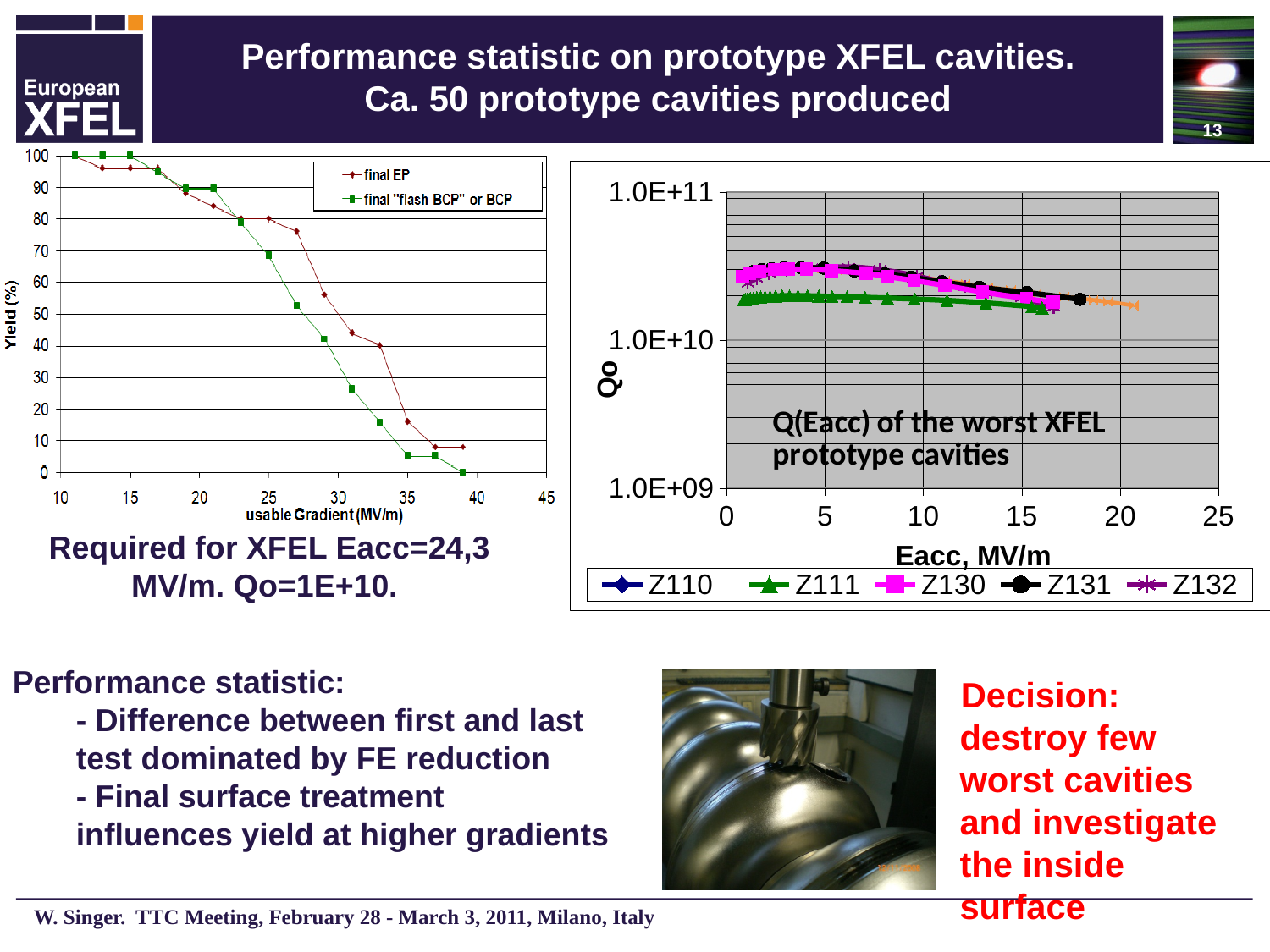
In the right chart (Qo versus Eacc), is the Qo value for Z111 at Eacc = 5 MV/m greater or less than 1.0E+10? greater In the left chart (Yield vs usable Gradient), does the yield rise or fall as the usable gradient increases? fall In the right chart (Qo versus Eacc), which series has the lower Qo at Eacc = 5 MV/m, Z111 or Z130? Z111 How many series does the legend of the left chart (Yield vs usable Gradient) list? 2 In the left chart (Yield vs usable Gradient), is the yield for 'final EP' at 35 MV/m greater or less than 20? less In the left chart (Yield vs usable Gradient), what are the two legend entries? final EP; final "flash BCP" or BCP What kind of chart is the left chart showing Yield (%) versus usable Gradient? line chart In the left chart (Yield vs usable Gradient), is the yield for 'final EP' at 25 MV/m greater or less than 70? greater How many series does the legend of the right chart (Qo versus Eacc) list? 5 What is the title printed inside the right chart (Qo versus Eacc)? Q(Eacc) of the worst XFEL prototype cavities In the left chart (Yield vs usable Gradient), which series has the higher yield at a usable gradient of 29 MV/m, 'final EP' or 'final "flash BCP" or BCP'? final EP